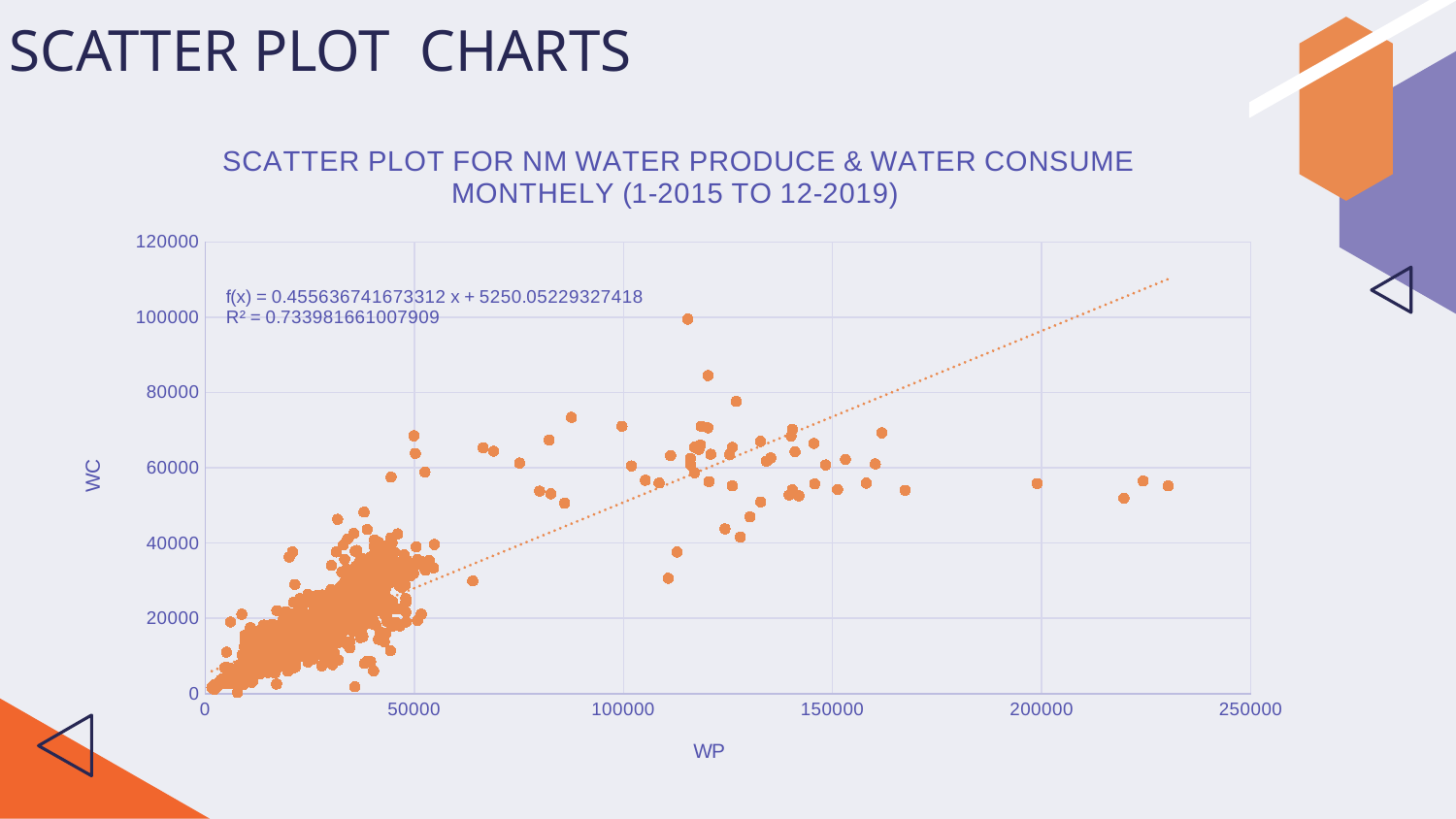
What is the title of the chart? SCATTER PLOT FOR NM WATER PRODUCE & WATER CONSUME MONTHELY (1-2015 TO 12-2019) Is the largest WP value plotted on the chart greater or less than 200000? greater What is the maximum value shown on the x axis (WP)? 250000 What label is shown on the x axis of the chart? WP As WP increases along the x axis, does WC generally rise or fall according to the trendline? Rise What is the R² value printed on the chart? R² = 0.733981661007909 What is the maximum value shown on the y axis (WC)? 120000 What is the trendline equation printed on the chart? f(x) = 0.455636741673312 x + 5250.05229327418 What kind of chart is shown on the slide? Scatter plot Is the slope of the trendline greater or less than 1? less Is the highest WC value plotted on the chart greater or less than 80000? greater